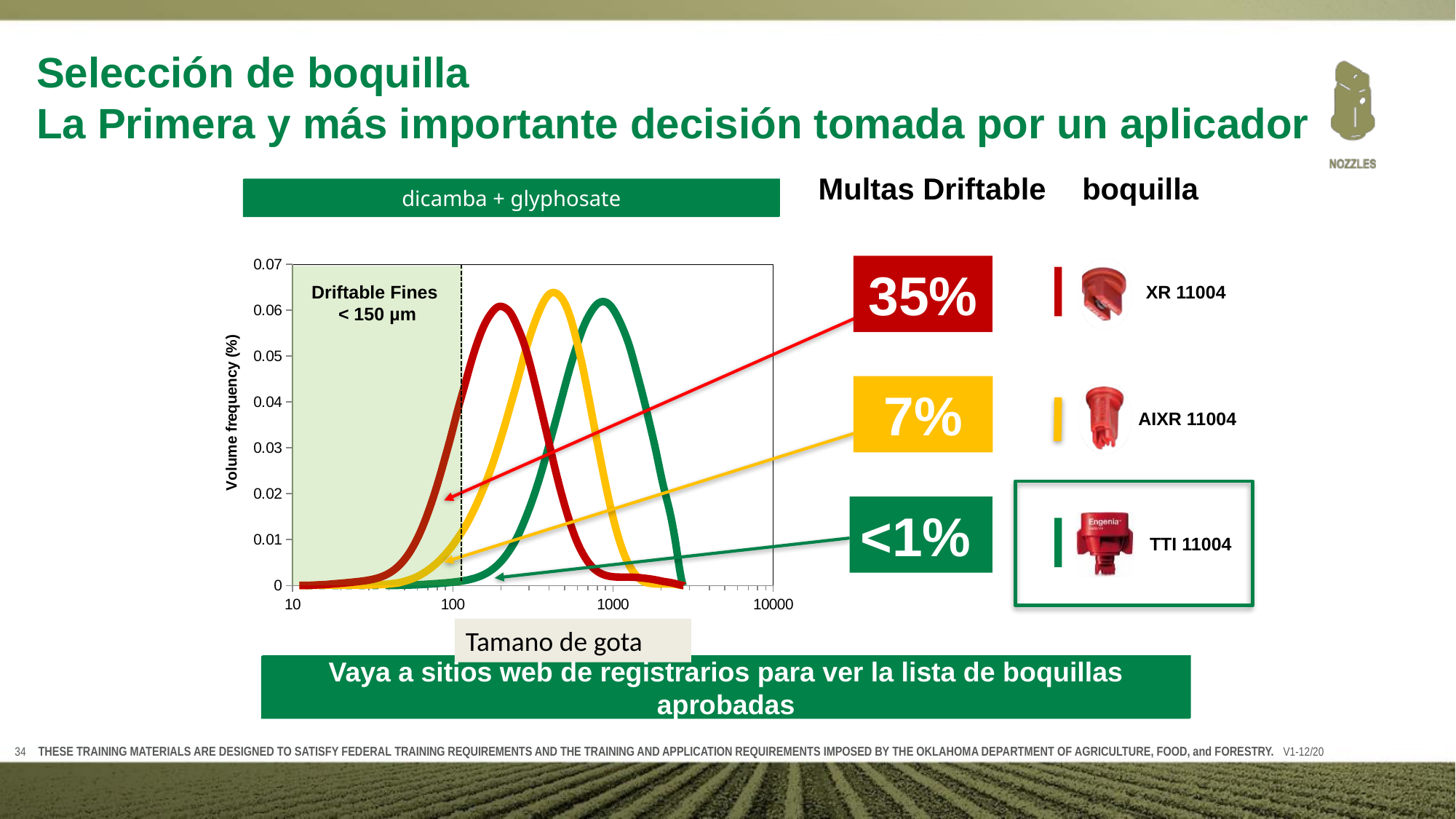
Which nozzle has a larger driftable fines percentage, XR 11004 or AIXR 11004? XR 11004 What is the difference in driftable fines percentage between the XR 11004 and AIXR 11004 nozzles? 28% What percentage of driftable fines is shown for the XR 11004 nozzle? 35% How many nozzle curves are plotted on the chart? 3 Is the peak of the green TTI 11004 curve greater or less than 0.05 on the volume frequency axis? greater What percentage of driftable fines is shown for the AIXR 11004 nozzle? 7% Which nozzle has the highest percentage of driftable fines? XR 11004 Which nozzle has the lowest percentage of driftable fines? TTI 11004 What kind of chart is shown on the slide? line chart What is the label of the y axis of the chart? Volume frequency (%) Below what droplet size are droplets classified as driftable fines on the chart? < 150 µm What percentage of driftable fines is shown for the TTI 11004 nozzle? <1%